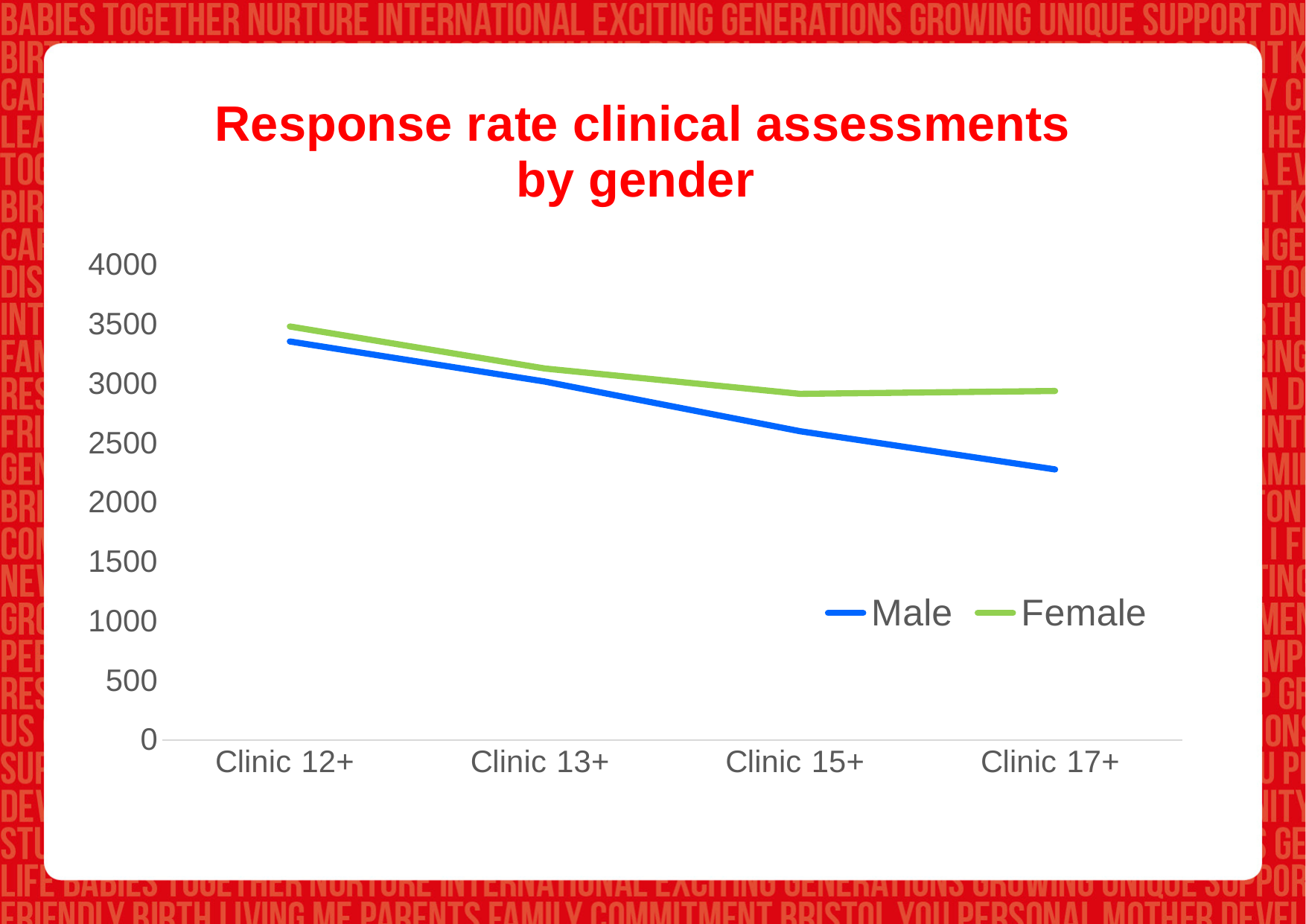
Do the Male values rise or fall from Clinic 12+ to Clinic 17+? fall What is the title of the chart? Response rate clinical assessments by gender At which clinic is the Male value highest? Clinic 12+ How many clinic categories are shown on the x axis? 4 Which series is drawn in green? Female Is the Female value for Clinic 15+ greater or less than 2500? greater Is the Male value for Clinic 12+ greater or less than 3000? greater At which clinic is the Male value lowest? Clinic 17+ How many series does the legend list? 2 At Clinic 17+, which series has the higher value, Male or Female? Female Is the Male value for Clinic 17+ greater or less than 2500? less What kind of chart is shown on the slide? line chart